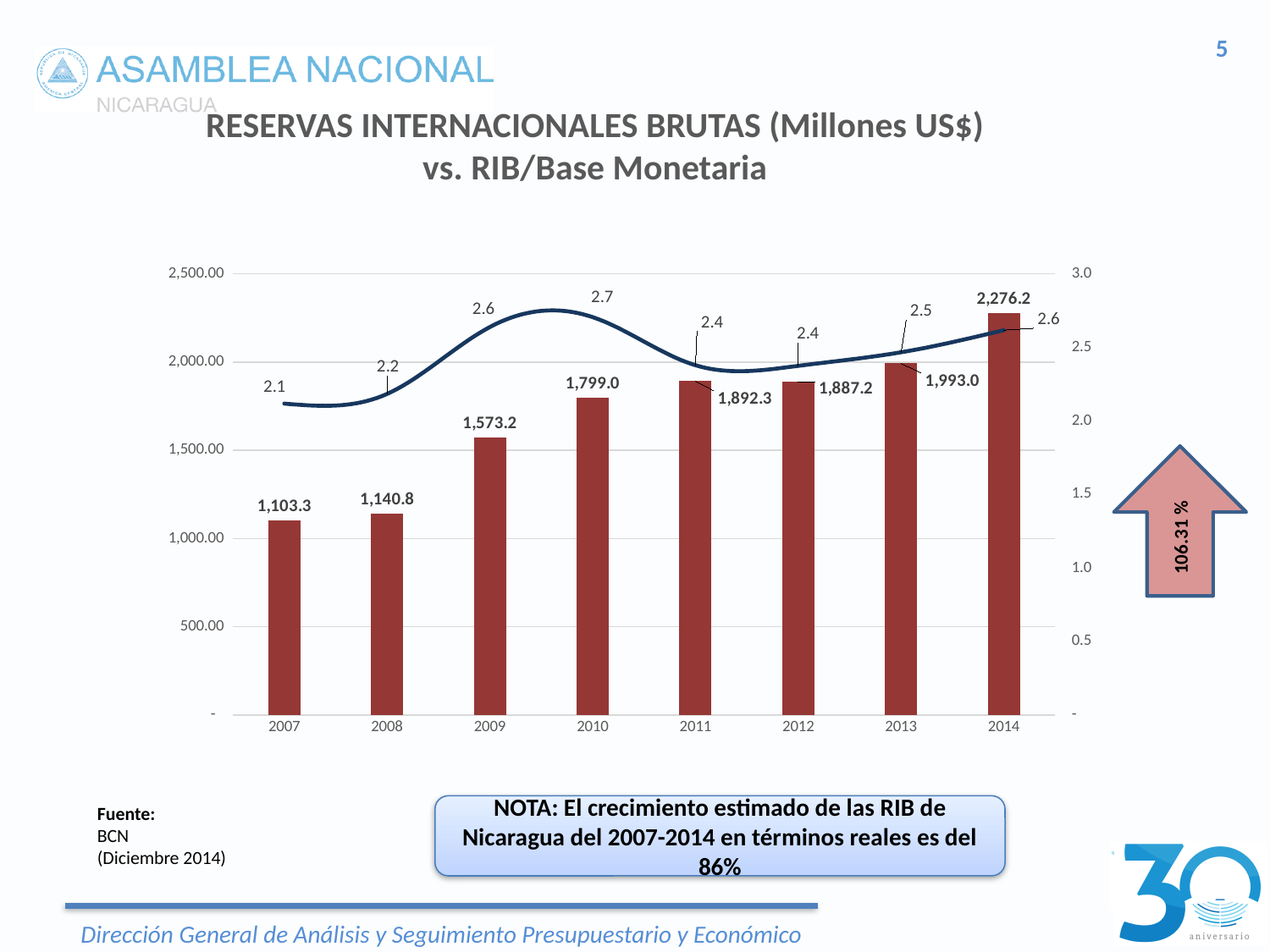
What is the RIB/Base Monetaria line value for 2010? 2.7 Which is larger, the Reservas Internacionales Brutas bar for 2011 or for 2012? 2011 What percentage is written inside the arrow to the right of the chart? 106.31 % What is the RIB/Base Monetaria line value for 2007? 2.1 Which year has the highest Reservas Internacionales Brutas bar? 2014 Do the Reservas Internacionales Brutas bars generally rise or fall from 2007 to 2014? Rise What is the difference between the Reservas Internacionales Brutas values for 2014 and 2007? 1,172.9 What kind of chart is shown on the slide? Combination bar and line chart How many years are shown on the x axis of the chart? 8 Which year has the lowest Reservas Internacionales Brutas bar? 2007 What is the value of the Reservas Internacionales Brutas bar for 2007? 1,103.3 What is the value of the Reservas Internacionales Brutas bar for 2014? 2,276.2